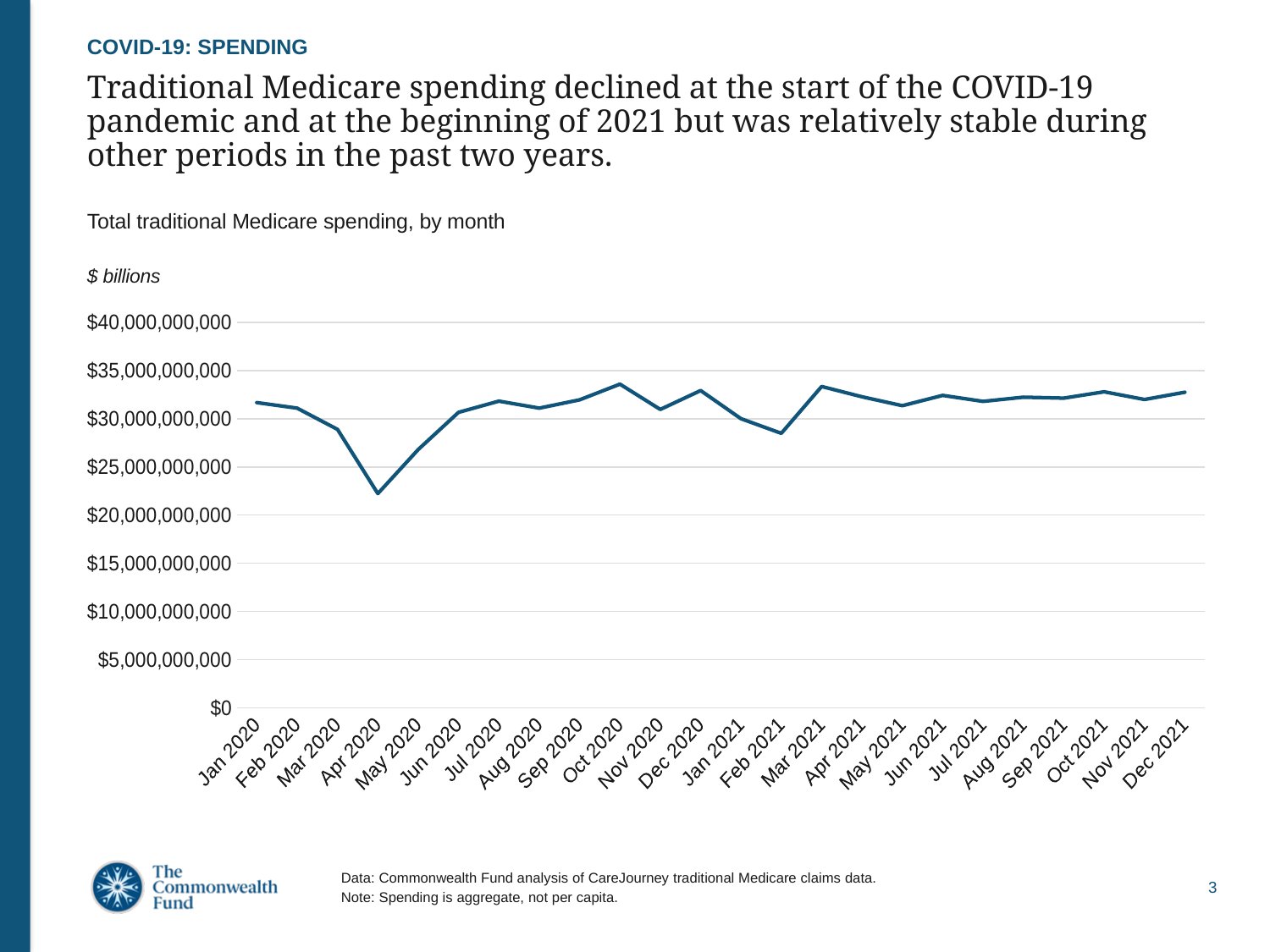
Is the value for Feb 2021 greater or less than $30,000,000,000? less Does spending rise or fall from Apr 2020 to Jul 2020? rise Does spending rise or fall from Mar 2020 to Apr 2020? fall Is the value for Apr 2020 greater or less than $25,000,000,000? less Which is larger, the value for Apr 2020 or the value for May 2020? May 2020 Which month has the lowest total traditional Medicare spending? Apr 2020 How many monthly data points are plotted on the chart? 24 What is the title of the chart? Total traditional Medicare spending, by month Which is larger, the value for Feb 2021 or the value for Mar 2021? Mar 2021 Is the value for Oct 2020 greater or less than $30,000,000,000? greater What kind of chart is shown on the slide? line chart